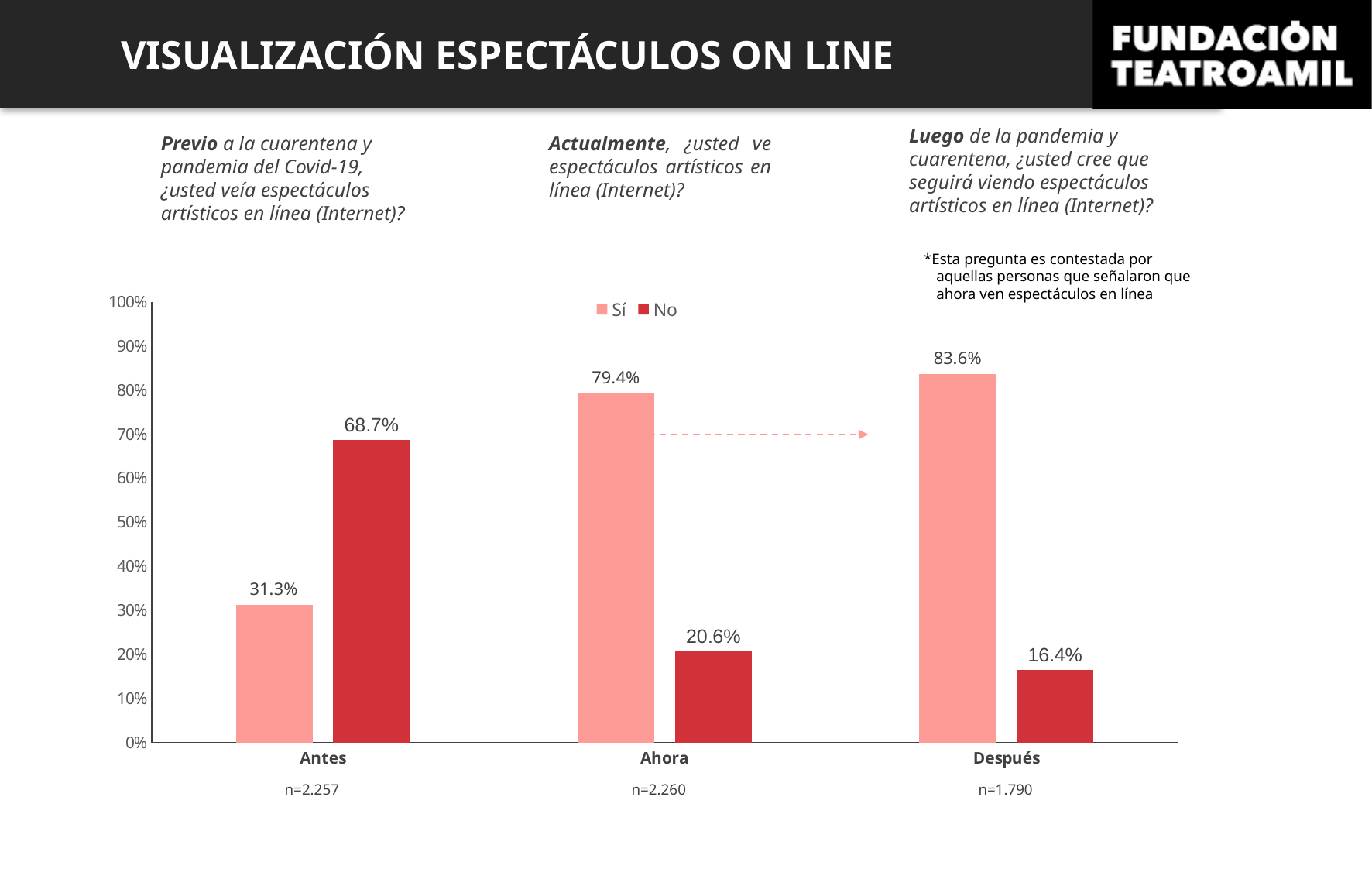
What is the value of the Sí series for Después? 83.6% What is the value of the No series for Antes? 68.7% What is the value of the No series for Ahora? 20.6% Which category has the highest Sí value? Después Does the Sí series rise or fall from Antes to Después? Rise What kind of chart is shown on the slide? Bar chart For Antes, which is larger, the Sí value or the No value? No How many categories are shown on the x axis? 3 What is the value of the Sí series for Antes? 31.3% What is the difference between the Sí and No values for Ahora? 58.8% How many series does the legend list? 2 Which category has the lowest No value? Después